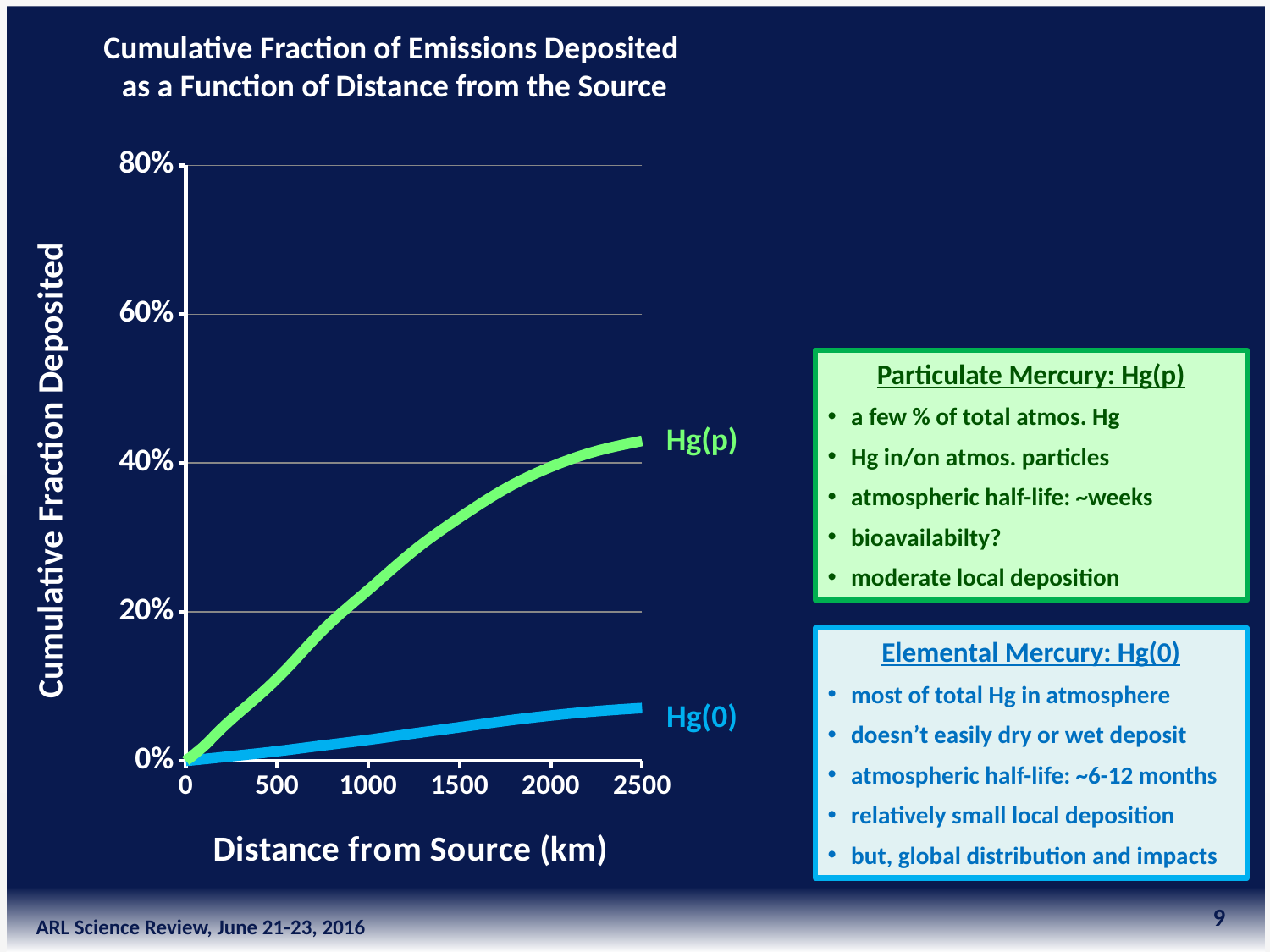
Which series reaches the highest cumulative fraction deposited on the chart? Hg(p) What kind of chart is shown on the slide? line chart How many series are plotted on the chart? 2 Is the value for Hg(p) at 500 km greater or less than 20%? less At 2500 km from the source, which series has the higher cumulative fraction deposited, Hg(p) or Hg(0)? Hg(p) What is the cumulative fraction deposited for Hg(0) at 0 km from the source? 0% Do the values for Hg(p) rise or fall as distance from the source increases? rise Is the value for Hg(p) at 1500 km greater or less than 20%? greater What is the label of the x axis of the chart? Distance from Source (km) Which series is drawn in green on the chart? Hg(p) Is the value for Hg(p) at 2500 km greater or less than 40%? greater